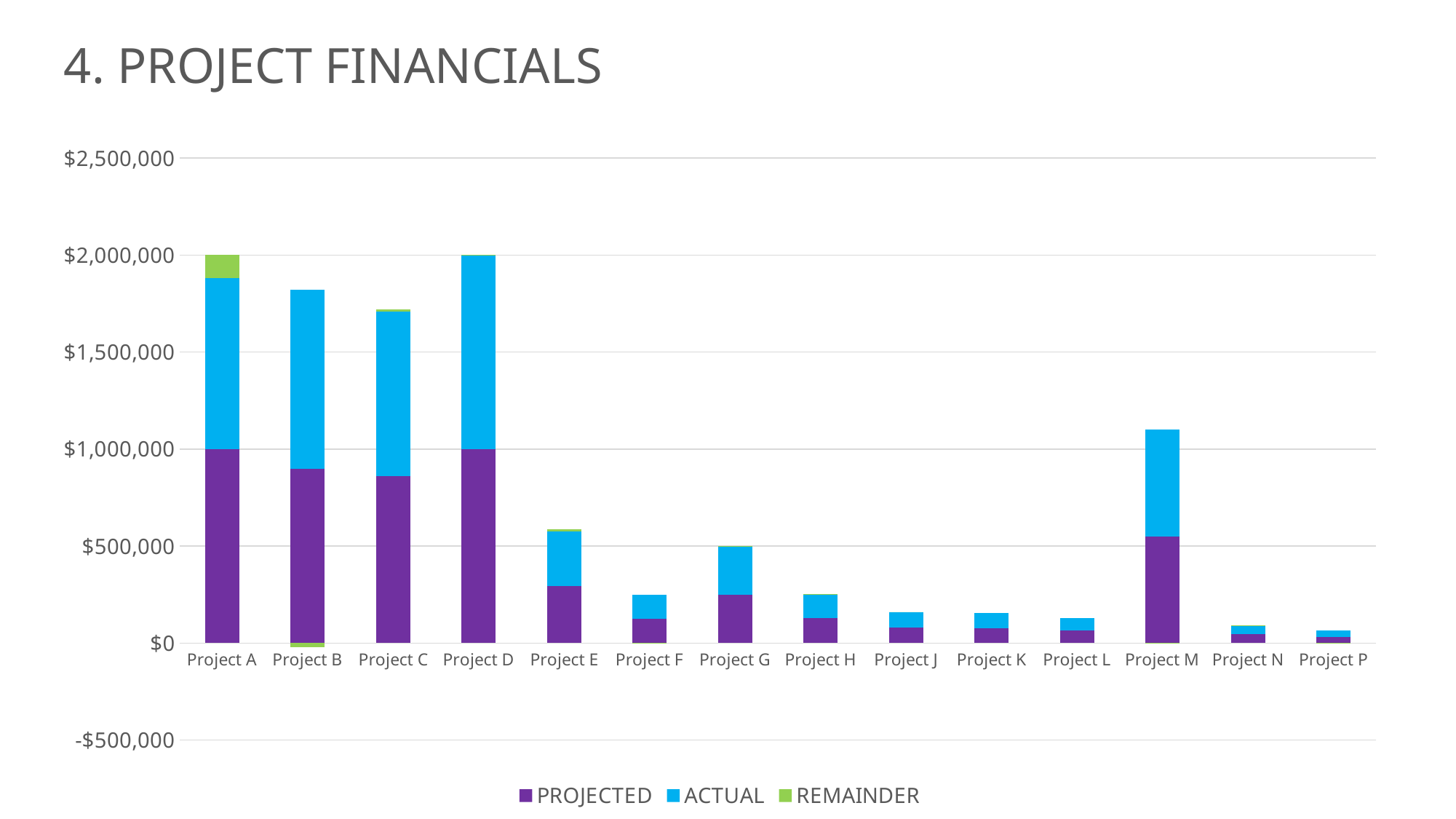
What kind of chart is shown on the slide? Stacked bar chart Which project has the larger REMAINDER segment, Project A or Project C? Project A What is the total height of the stacked bar for Project A? $2,000,000 Is the total stacked value for Project B greater or less than $1,500,000? greater What is the title of the slide containing the chart? 4. PROJECT FINANCIALS Which project has the lowest total stacked value? Project P Is the total stacked value for Project F greater or less than $500,000? less How many series does the chart's legend list? 3 How many projects are shown on the x axis of the chart? 14 Which has the larger total stacked value, Project B or Project M? Project B Is the total stacked value for Project M greater or less than $1,000,000? greater What is the PROJECTED value for Project A? $1,000,000